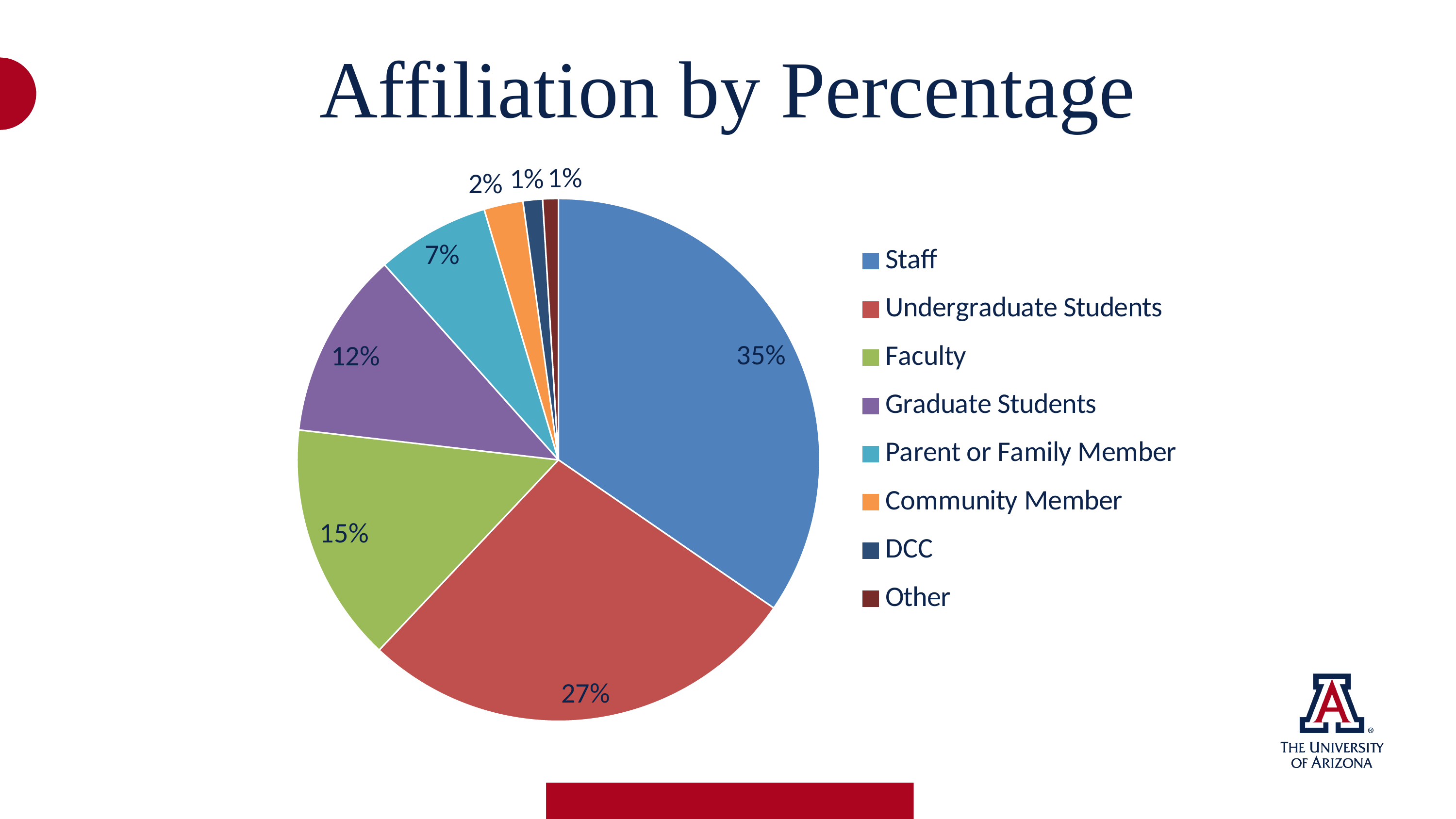
What percentage of the pie is Staff? 35% What percentage of the pie is Faculty? 15% What is the title of the chart? Affiliation by Percentage What percentage of the pie is Community Member? 2% What kind of chart is shown on the slide? pie chart What percentage of the pie is Graduate Students? 12% What percentage of the pie is Undergraduate Students? 27% Which share is larger, Faculty or Graduate Students? Faculty How many categories does the legend list? 8 What percentage of the pie is Parent or Family Member? 7% Which affiliation has the largest share of the pie? Staff How many percentage points larger is the Staff share than the Undergraduate Students share? 8